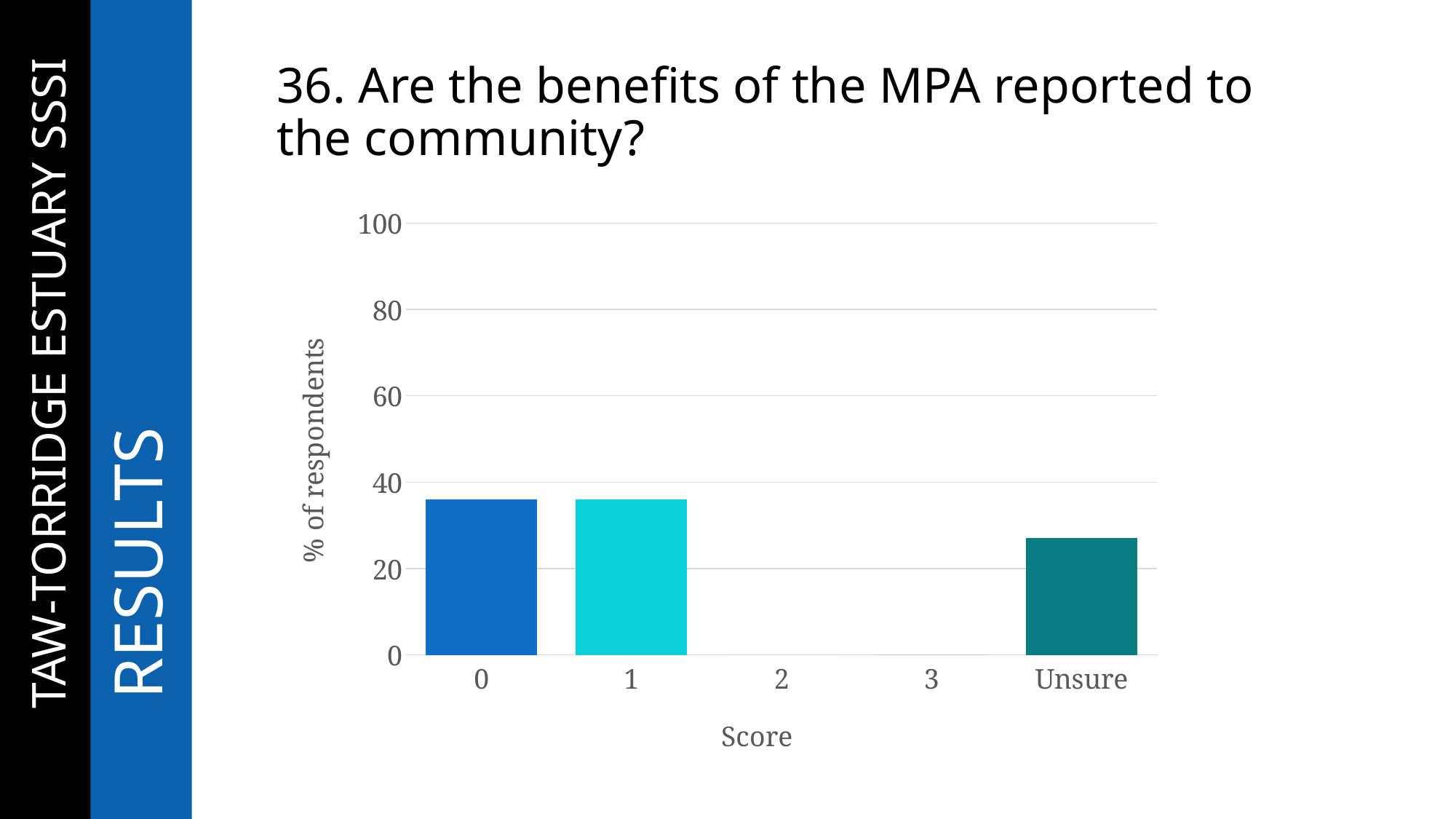
What is the label of the y axis? % of respondents Is the value for Unsure greater or less than 20? greater What is the value for score 2? 0 Is the value for score 1 greater or less than 40? less What kind of chart is shown on the slide? bar chart Is the value for Unsure greater or less than 40? less What is the label of the x axis? Score Which is larger, the value for score 1 or the value for score 2? score 1 How many categories are shown on the x axis of the chart? 5 Which is larger, the value for score 0 or the value for Unsure? score 0